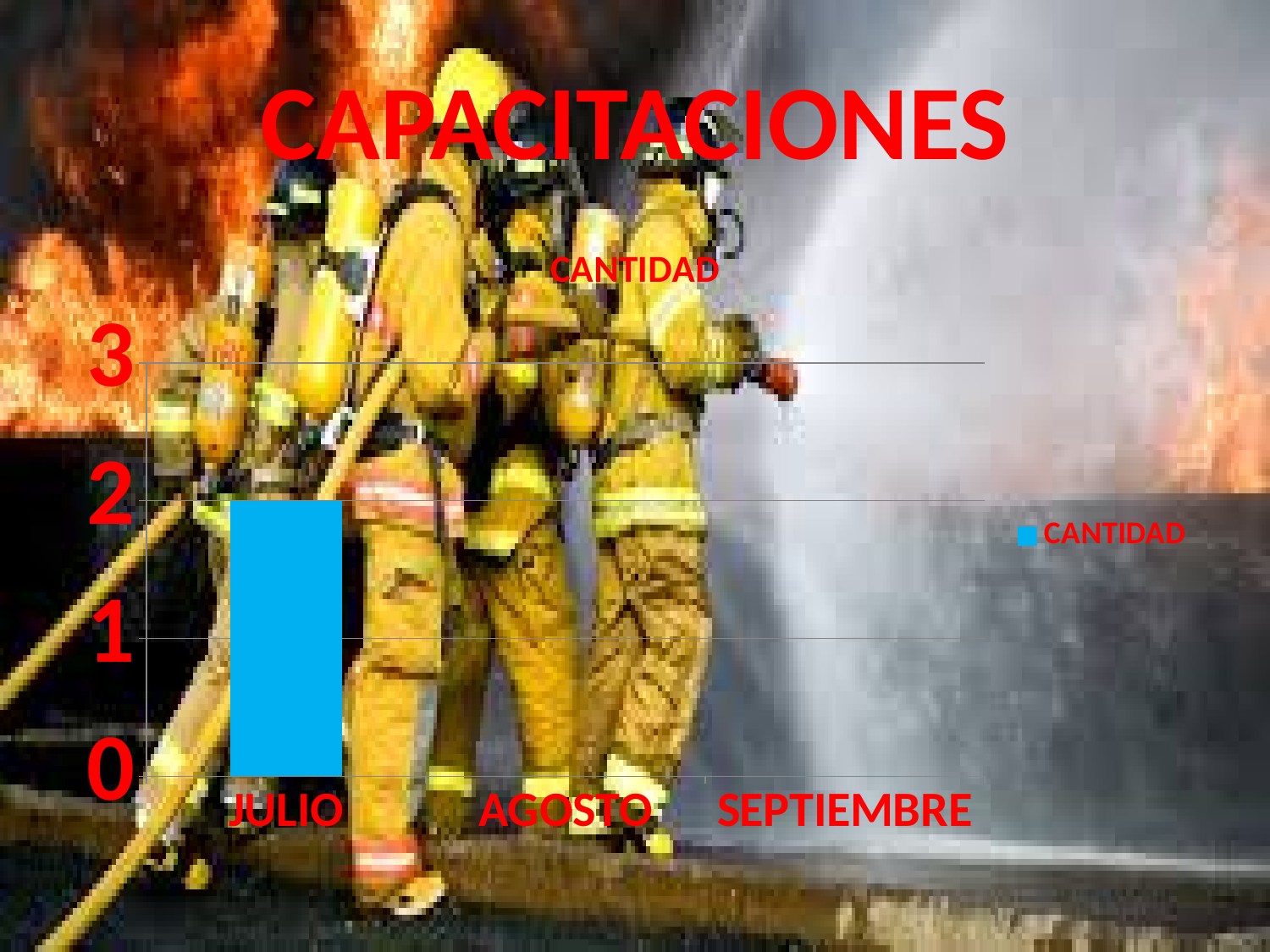
Is the value for JULIO greater or less than 3? less Which is larger, the value for JULIO or the value for AGOSTO? JULIO Which is larger, the value for JULIO or the value for SEPTIEMBRE? JULIO What is the value for JULIO in the chart? 2 Which category has the highest value in the chart? JULIO What is the highest value shown on the y axis of the chart? 3 What series name appears in the chart legend? CANTIDAD What is the title of the chart? CANTIDAD How many series does the chart legend list? 1 What type of chart is shown on the slide? bar chart How many categories are shown on the x axis of the chart? 3 Is the value for JULIO greater or less than 1? greater